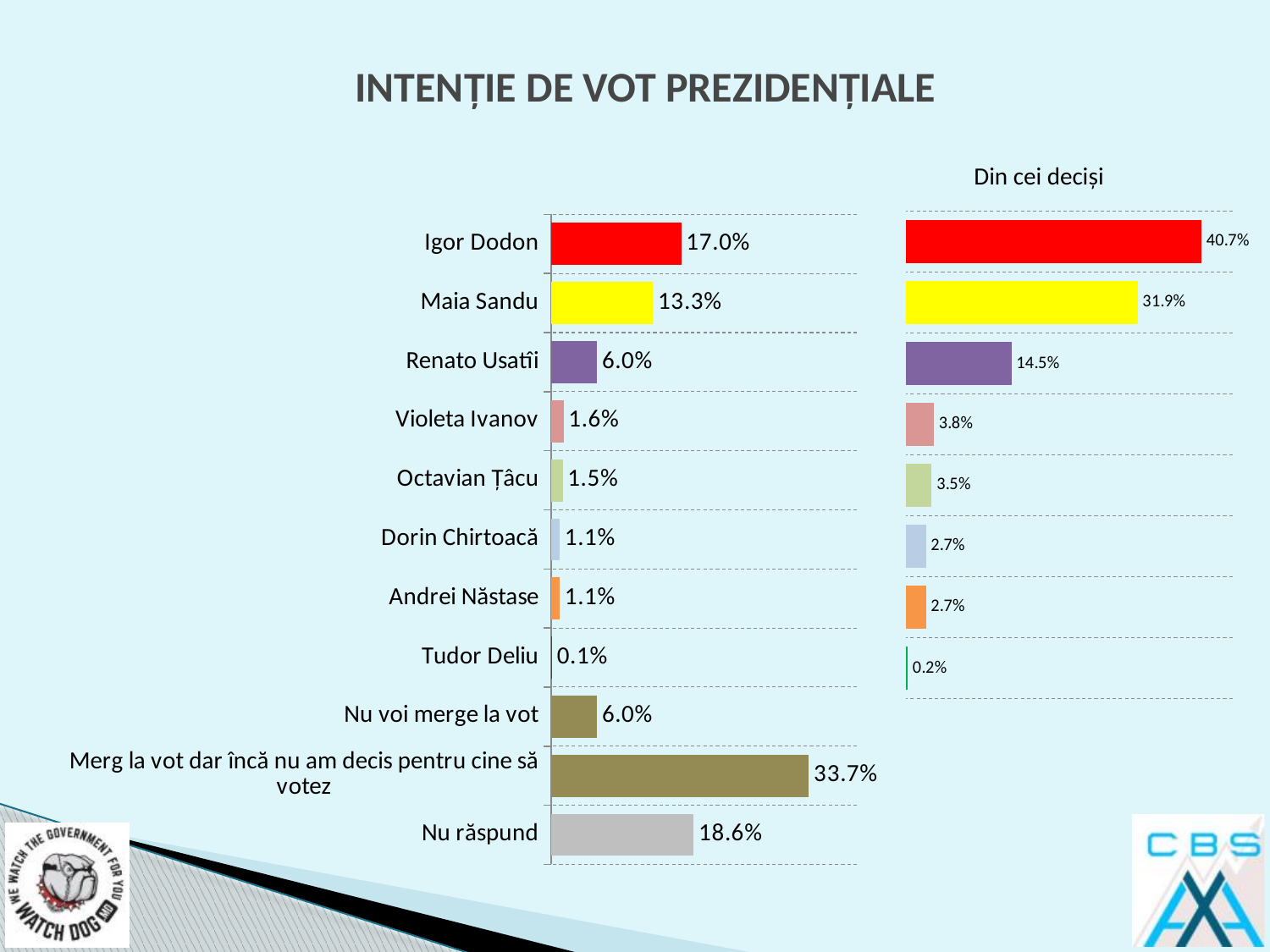
In the left chart, which category has the highest value? Merg la vot dar încă nu am decis pentru cine să votez In the 'Din cei deciși' chart, which candidate has the highest value? Igor Dodon What type of chart is used on this slide? Bar chart In the 'Din cei deciși' chart, which candidate has the lowest value? Tudor Deliu In the 'Din cei deciși' chart, what is the value for Maia Sandu? 31.9% In the left chart, what is the value for Igor Dodon? 17.0% How many categories are shown in the left chart? 11 In the left chart, what is the value for 'Merg la vot dar încă nu am decis pentru cine să votez'? 33.7% How many candidates are shown in the 'Din cei deciși' chart? 8 In the left chart, what is the difference between Igor Dodon and Maia Sandu? 3.7% In the left chart, which is larger: the value for Renato Usatîi or the value for Nu răspund? Nu răspund In the 'Din cei deciși' chart, what is the difference between Igor Dodon and Renato Usatîi? 26.2%